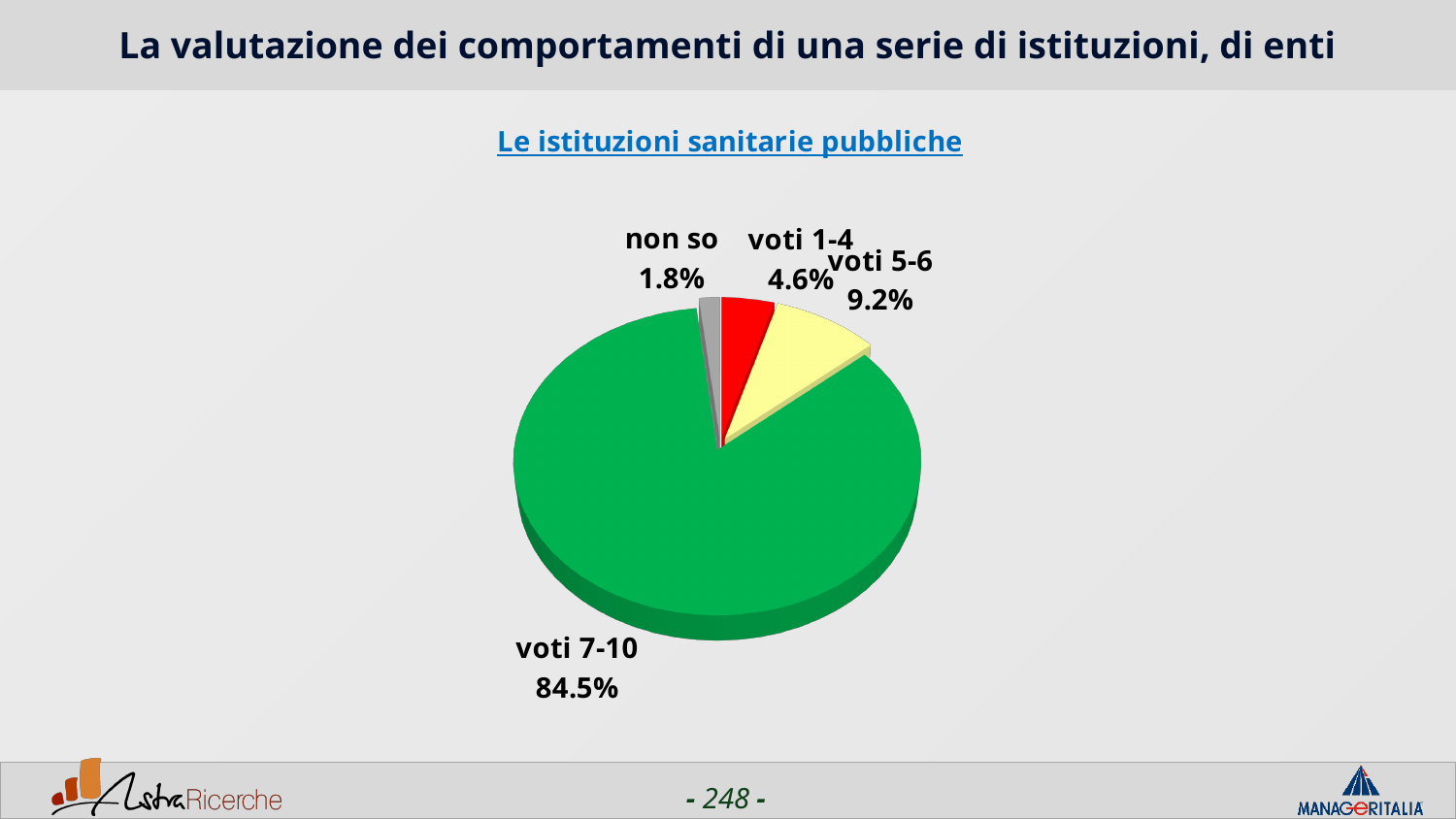
What percentage is shown for 'non so'? 1.8% What is the subtitle of the chart? Le istituzioni sanitarie pubbliche What colour is the slice for 'voti 7-10'? green Which category has the largest share of the pie? voti 7-10 What kind of chart is shown on the slide? pie chart Which category has the smallest share of the pie? non so What percentage is shown for 'voti 1-4'? 4.6% Which is larger, the share for 'voti 1-4' or the share for 'non so'? voti 1-4 What percentage is shown for 'voti 7-10'? 84.5% What percentage is shown for 'voti 5-6'? 9.2% How many slices does the pie chart have? 4 What is the difference between the shares of 'voti 5-6' and 'voti 1-4'? 4.6%